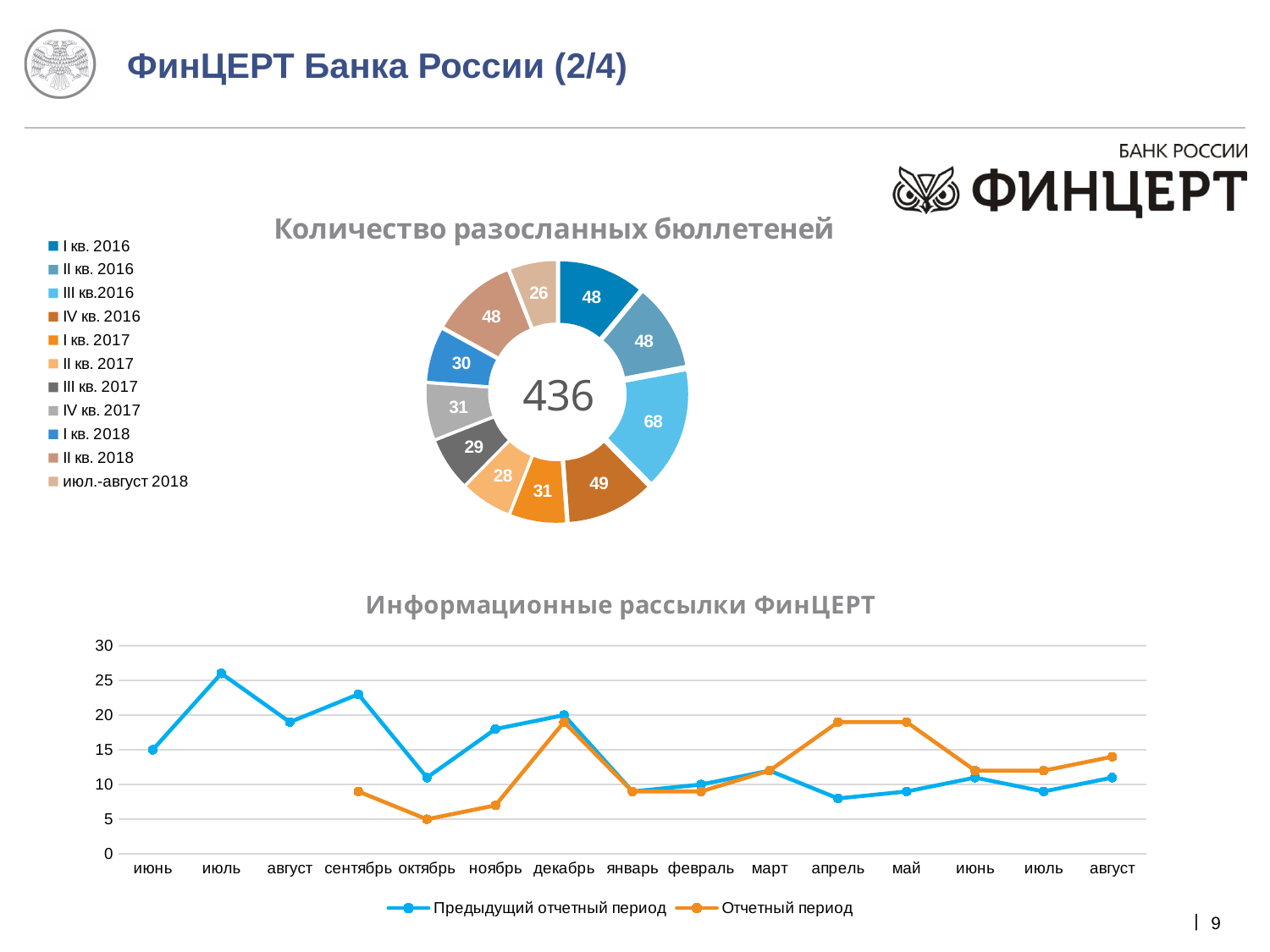
On the donut chart 'Количество разосланных бюллетеней', which quarter has the highest value? III кв.2016 On the donut chart 'Количество разосланных бюллетеней', what is the value for III кв.2016? 68 On the donut chart 'Количество разосланных бюллетеней', what is the difference between III кв.2016 and II кв. 2017? 40 On the donut chart 'Количество разосланных бюллетеней', how many segments does the legend list? 11 On the donut chart 'Количество разосланных бюллетеней', what is the value for июл.-август 2018? 26 On the line chart 'Информационные рассылки ФинЦЕРТ', is the value for 'Предыдущий отчетный период' in июль (the first июль) greater or less than 25? greater What type of chart is 'Информационные рассылки ФинЦЕРТ'? Line chart How many series does the legend of 'Информационные рассылки ФинЦЕРТ' list? 2 On the donut chart 'Количество разосланных бюллетеней', which is larger: I кв. 2018 or II кв. 2018? II кв. 2018 On the donut chart 'Количество разосланных бюллетеней', what is the value for IV кв. 2016? 49 On the donut chart 'Количество разосланных бюллетеней', what total is shown in the centre? 436 On the line chart 'Информационные рассылки ФинЦЕРТ', is the value for 'Отчетный период' in октябрь greater or less than 10? less